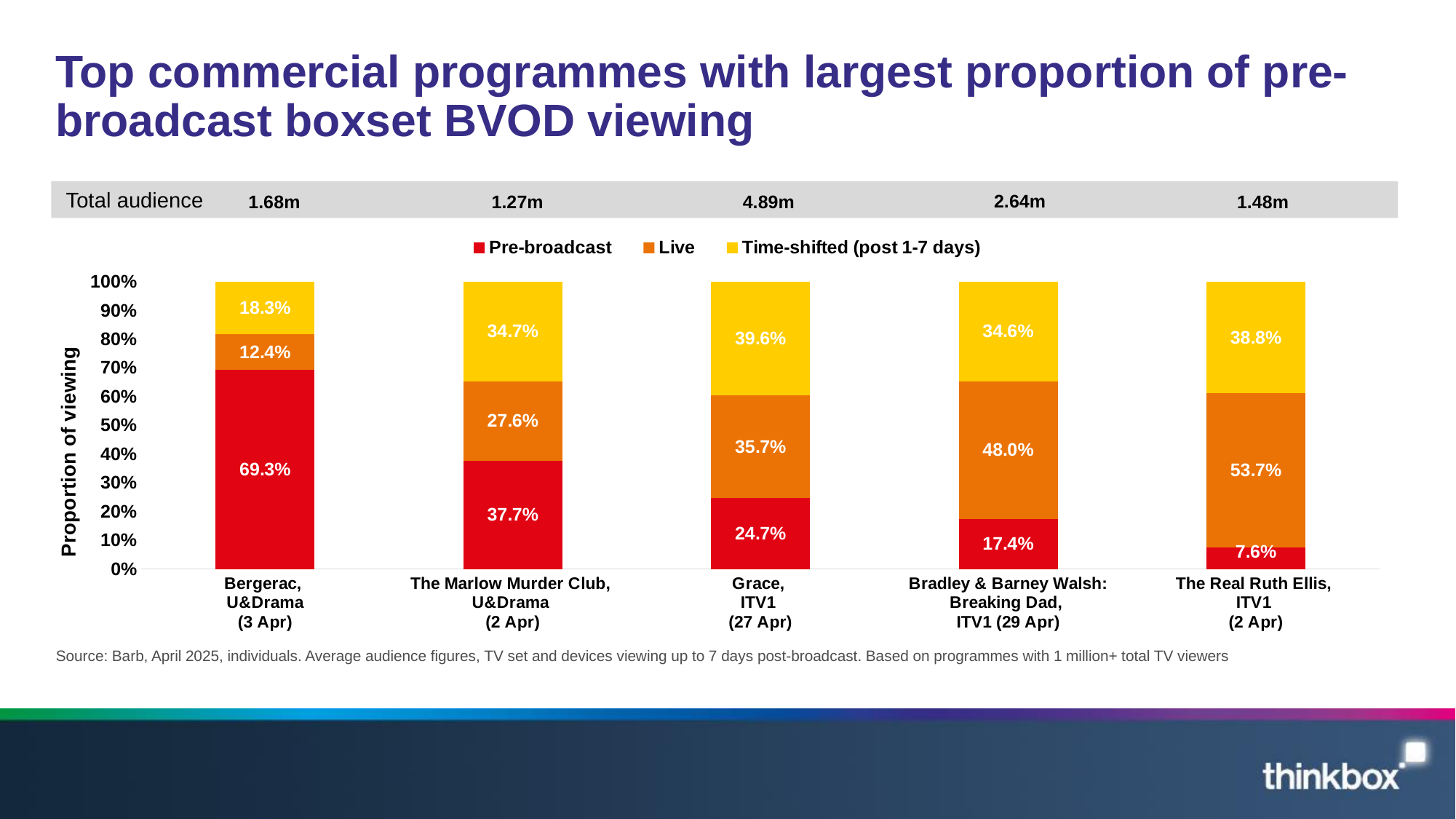
What is the Time-shifted (post 1-7 days) share of viewing for Grace, ITV1 (27 Apr)? 39.6% What is the total audience shown for Grace, ITV1 (27 Apr)? 4.89m How many series does the legend list? 3 What kind of chart is shown on the slide? Stacked bar chart Which is larger: the Live share for Bradley & Barney Walsh: Breaking Dad or the Live share for Grace? Bradley & Barney Walsh: Breaking Dad Which programme has the lowest Pre-broadcast share of viewing? The Real Ruth Ellis, ITV1 (2 Apr) What is the Pre-broadcast share of viewing for Bergerac, U&Drama (3 Apr)? 69.3% What is the Live share of viewing for The Real Ruth Ellis, ITV1 (2 Apr)? 53.7% How many programmes are shown on the chart? 5 Which programme has the highest Pre-broadcast share of viewing? Bergerac, U&Drama (3 Apr) Which colour represents the Live series in the legend? Orange What is the difference between the Pre-broadcast shares of Bergerac and The Marlow Murder Club? 31.6%